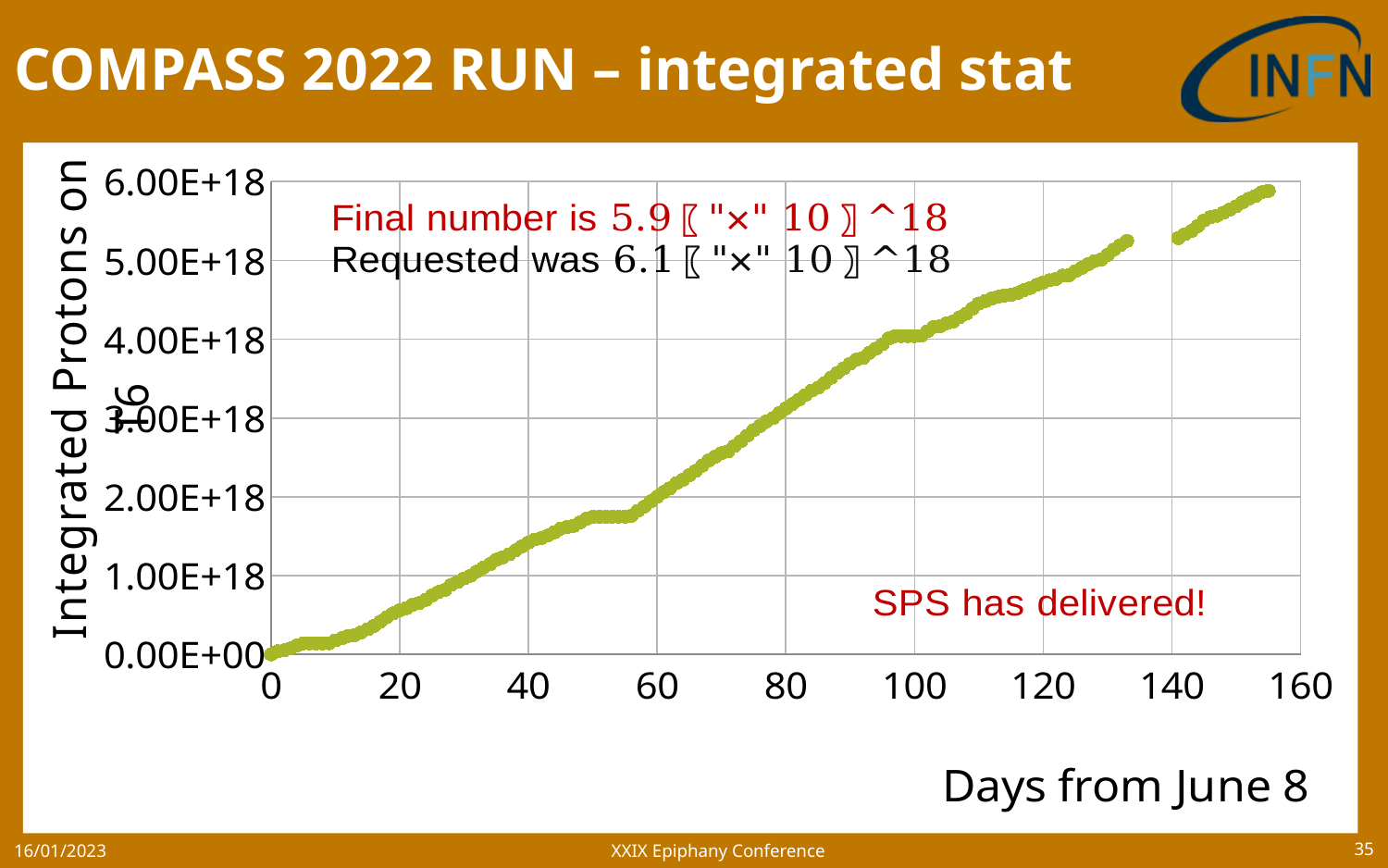
What kind of chart is shown on the slide? scatter chart Do the plotted values rise or fall as the number of days from June 8 increases? rise What is the title of the x axis of the chart? Days from June 8 Is the value at day 20 greater or less than 1.00E+18? less Is the value at day 120 greater or less than 4.00E+18? greater Is the value at day 120 greater or less than 5.00E+18? less What red annotation appears in the lower right of the chart area? SPS has delivered!